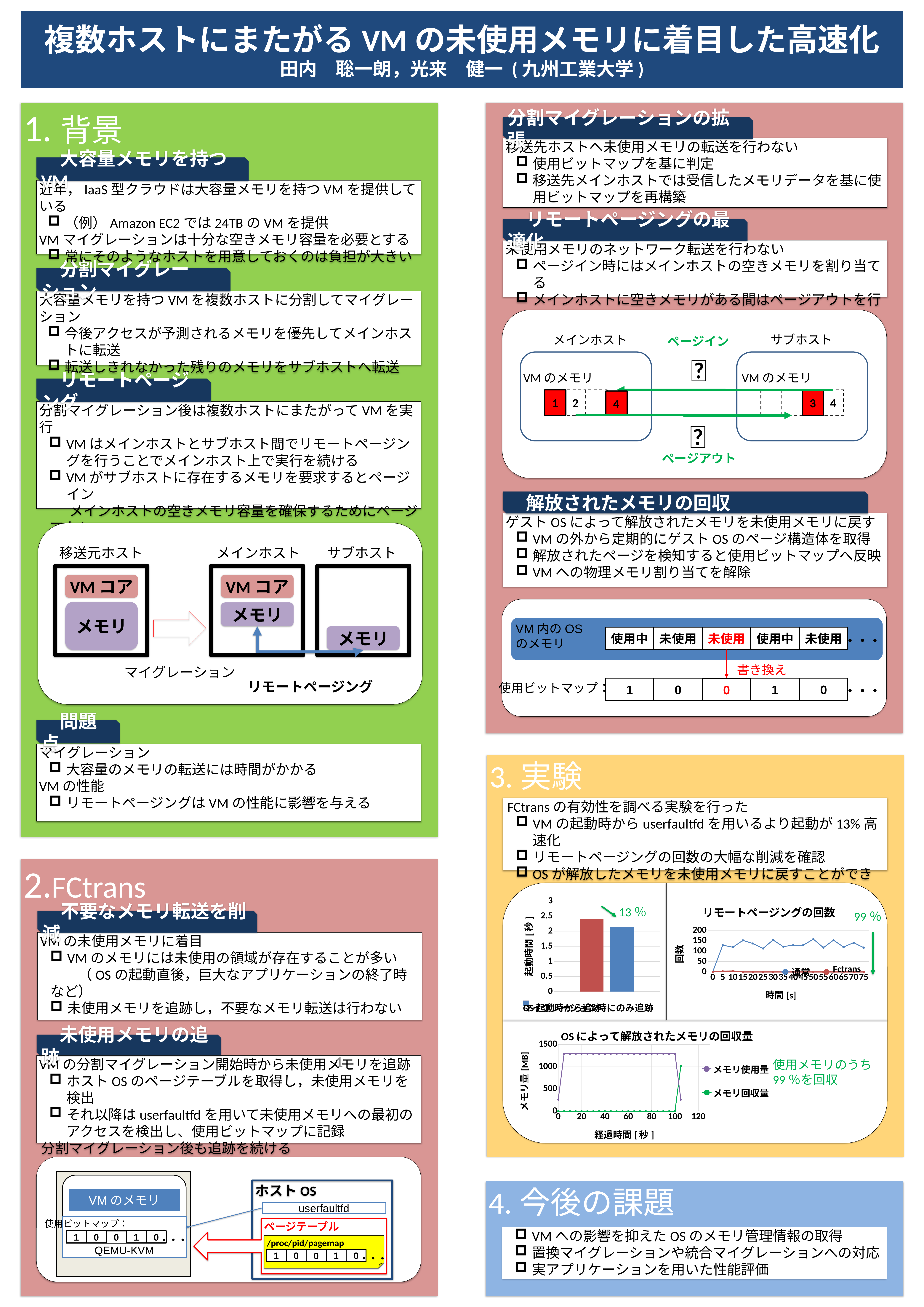
In the リモートページングの回数 chart, is the 通常 value at 時間 5 greater or less than 50? greater How many series does the legend of the OSによって解放されたメモリの回収量 chart list? 2 In the 起動時間 [秒] chart, which bar is taller, the left (red) one or the right (blue) one? the left (red) one In the 起動時間 [秒] chart, is the value of the right (blue) bar greater or less than 2.5? less How many series does the legend of the リモートページングの回数 chart list? 2 In the リモートページングの回数 chart, which series has the higher values, 通常 or Fctrans? 通常 In the 起動時間 [秒] chart, is the value of the left (red) bar greater or less than 2? greater What kind of chart is the リモートページングの回数 chart? line chart How many bars are plotted in the 起動時間 [秒] chart? 2 What kind of chart is the 起動時間 [秒] chart in section 3. 実験? bar chart What percentage reduction is annotated on the リモートページングの回数 chart? 99 %